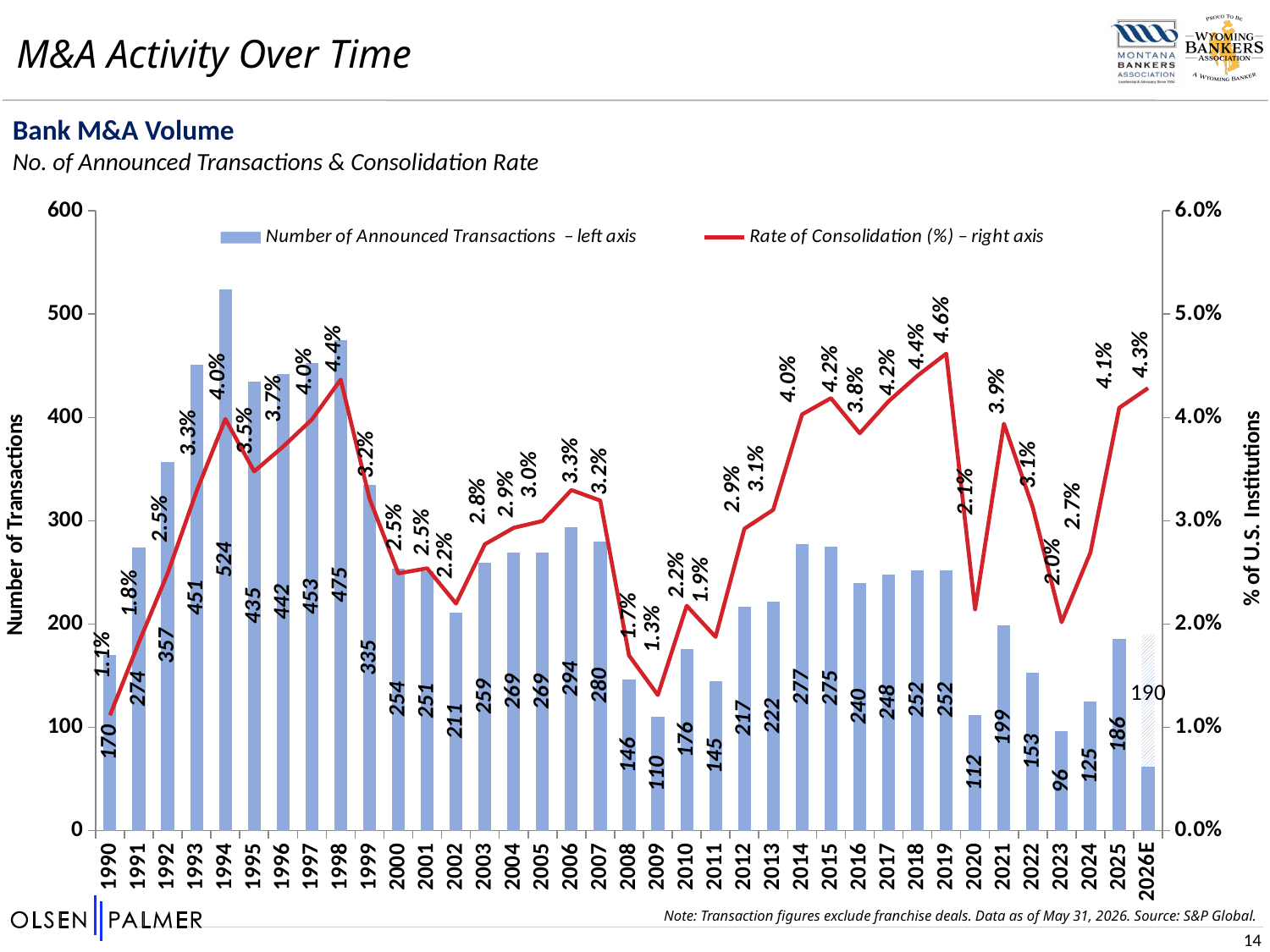
Did the rate of consolidation rise or fall from 2019 to 2020? Fall Which year had more announced transactions, 2008 or 2010? 2010 What type of chart is used for the Number of Announced Transactions series? Bar chart How many series does the legend list? 2 How many years are shown on the x axis? 37 Which year had the lowest number of announced transactions? 2023 Which year had the lowest rate of consolidation? 1990 What was the rate of consolidation in 2019? 4.6% How many announced transactions were there in 1994? 524 What is the estimated number of announced transactions for 2026E? 190 What is the difference in the number of announced transactions between 2025 and 2024? 61 Which year had the highest number of announced transactions? 1994